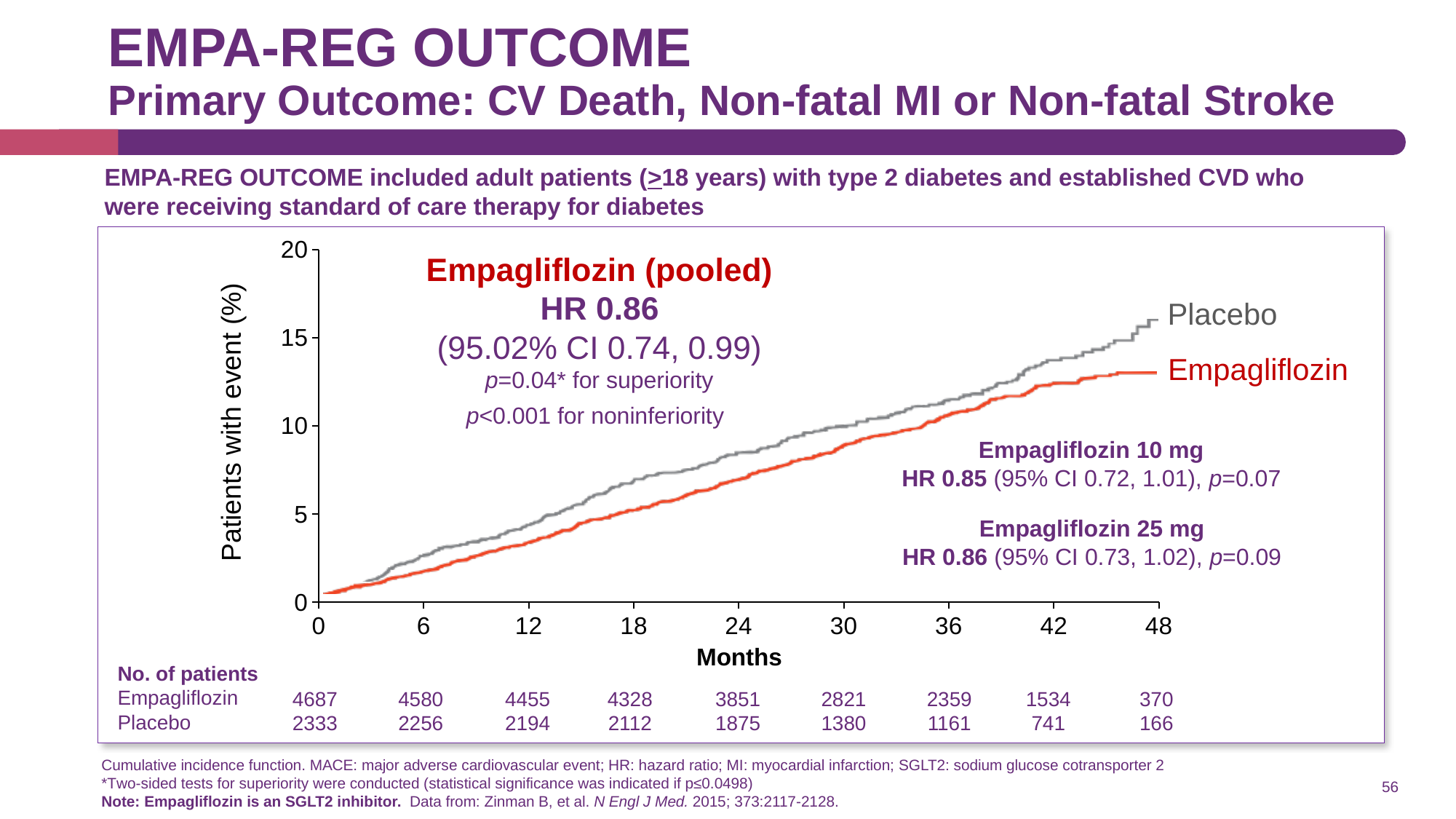
Is the percentage of Empagliflozin patients with an event at 48 months greater or less than 15? less What is the hazard ratio for pooled Empagliflozin shown on the chart? 0.86 Is the percentage of Placebo patients with an event at 48 months greater or less than 15? greater Which group has the higher cumulative incidence of events at 48 months, Placebo or Empagliflozin? Placebo What is the label of the y-axis? Patients with event (%) How many patients were in the Placebo group at 48 months? 166 What is the p-value for superiority shown on the chart? 0.04 How many patients were in the Empagliflozin group at 0 months? 4687 What is the difference between the number of Empagliflozin and Placebo patients at 0 months? 2354 How many treatment groups (lines) are plotted on the chart? 2 Do the cumulative incidence curves rise or fall as months increase? Rise What kind of chart is shown on the slide? Line chart